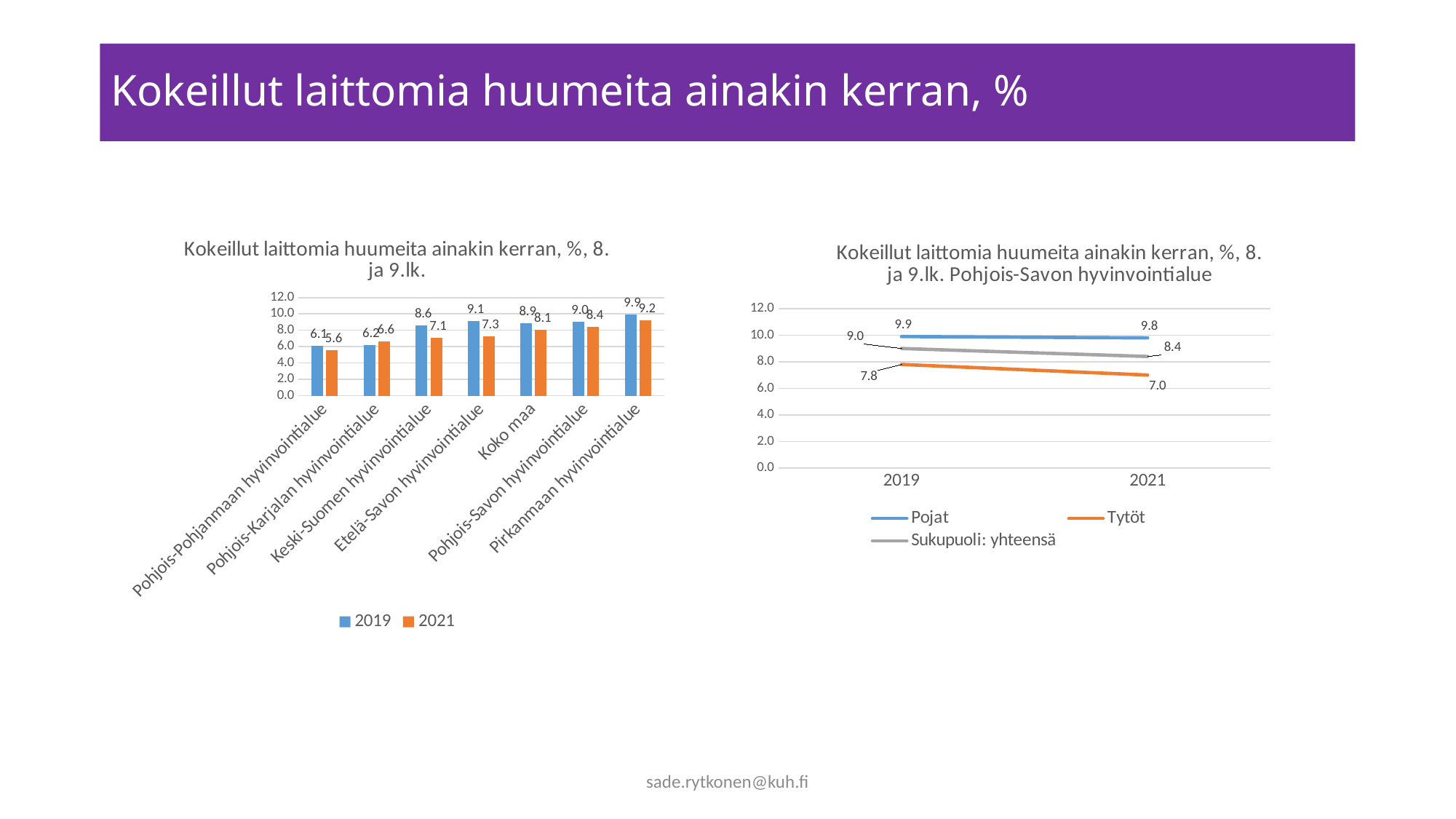
In the right line chart, does the Sukupuoli: yhteensä line rise or fall from 2019 to 2021? Fall In the right line chart, how many series does the legend list? 3 How many categories are shown on the x axis of the left bar chart? 7 In the left bar chart, what is the 2021 value for Keski-Suomen hyvinvointialue? 7.1 In the left bar chart, which category has the lowest 2021 value? Pohjois-Pohjanmaan hyvinvointialue In the right line chart, what is the value for Tytöt in 2021? 7.0 In the left bar chart, which is larger for Pohjois-Karjalan hyvinvointialue, the 2019 value or the 2021 value? 2021 In the right line chart, what is the difference between the Pojat and Tytöt values in 2019? 2.1 In the left bar chart, which category has the highest 2019 value? Pirkanmaan hyvinvointialue In the left bar chart, what is the difference between the 2019 and 2021 values for Etelä-Savon hyvinvointialue? 1.8 What type of chart is the chart on the left of the slide? Bar chart In the left bar chart, what is the 2019 value for Koko maa? 8.9